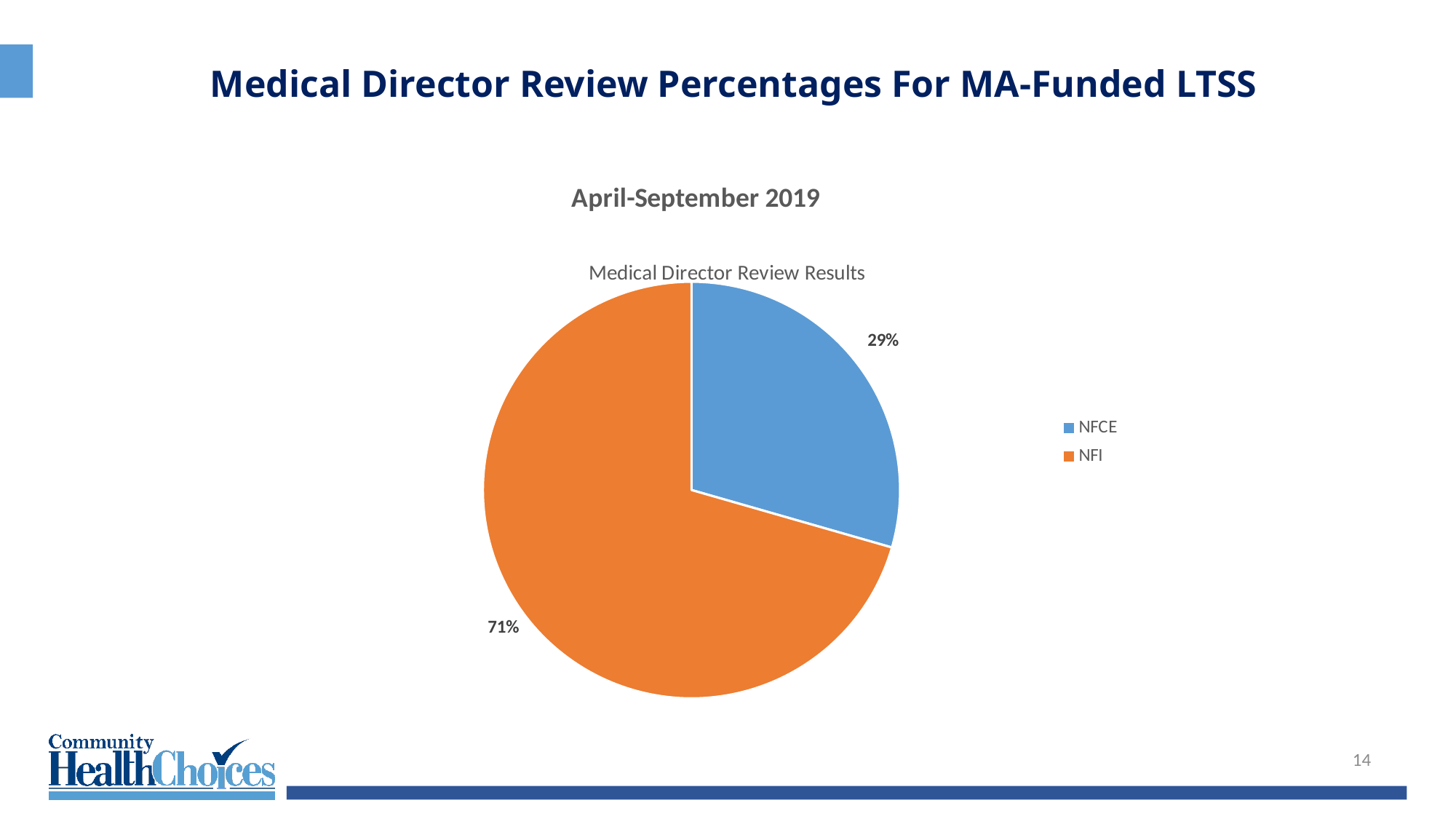
What percentage of the pie does NFI represent? 71% What is the title of the chart? April-September 2019 What time period does the chart cover, according to the subtitle above it? April-September 2019 How many slices does the pie chart have? 2 Which category has the largest share of the pie? NFI What percentage of the pie does NFCE represent? 29% Which is larger, the NFCE share or the NFI share? NFI What kind of chart is shown on the slide? Pie chart What colour is the NFI slice? Orange What is the difference in percentage points between the NFI and NFCE shares? 42 How many entries does the legend list? 2 Which category has the smallest share of the pie? NFCE